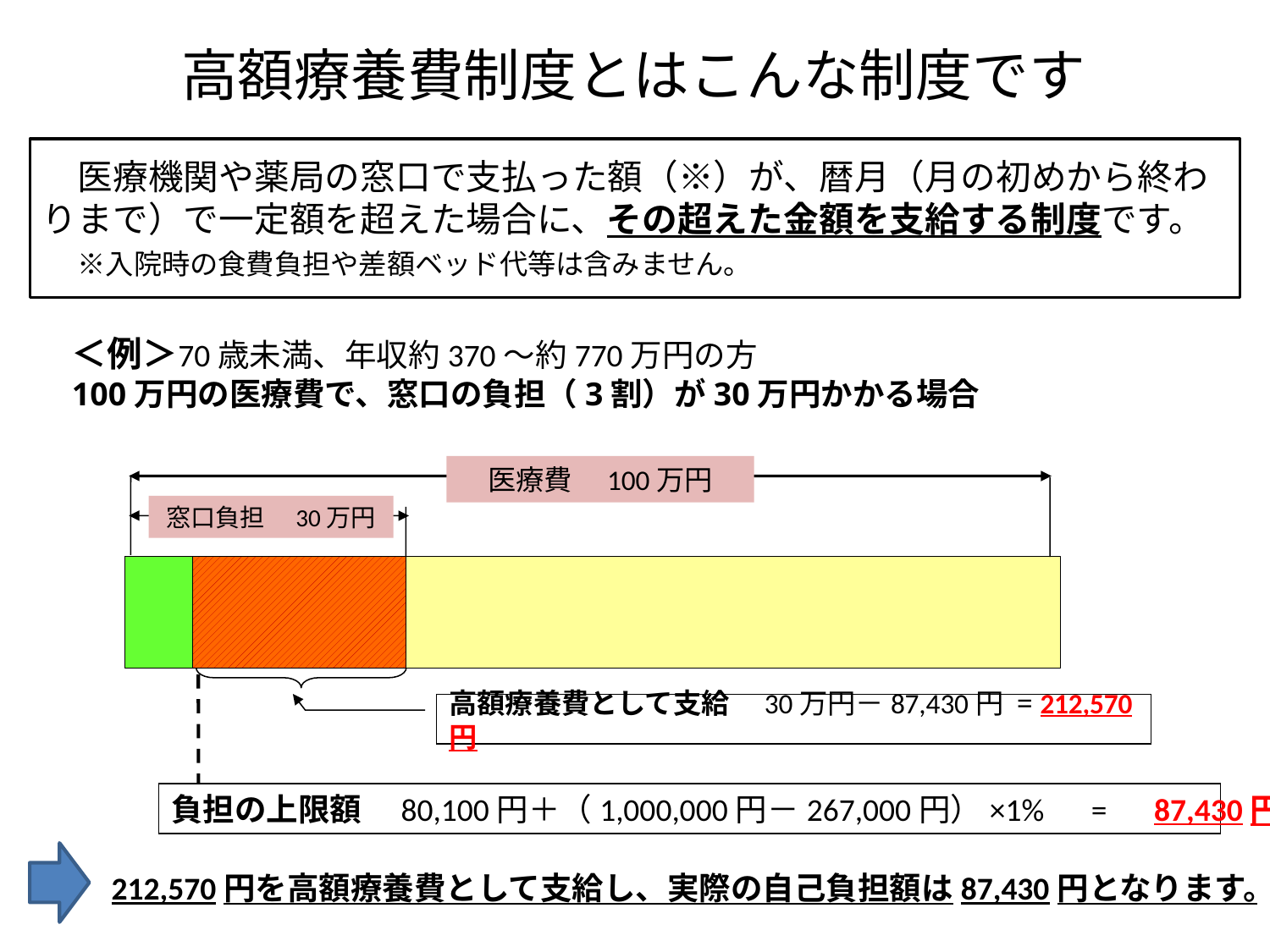
What total medical cost (医療費) does the top arrow of the bar diagram represent? 100万円 What amount is paid out as 高額療養費 according to the diagram? 212,570円 Which is larger, the 高額療養費 paid out or the 負担の上限額? 高額療養費 (212,570円) What fraction of the 医療費 does the 窓口負担 represent, as stated on the slide? 3割 What colour is the hatched segment of the bar that corresponds to the 高額療養費 paid out? Orange What kind of chart is used to illustrate the example? Horizontal stacked bar chart What is the window payment (窓口負担) amount shown above the bar? 30万円 What is the difference between the 窓口負担 of 30万円 and the 負担の上限額 of 87,430円? 212,570円 What colour is the segment of the bar that corresponds to the 負担の上限額 (87,430円)? Green What is the 負担の上限額 (upper limit of self-payment) shown in the diagram? 87,430円 How many coloured segments make up the horizontal bar in the diagram? 3 What is the difference between the 医療費 (100万円) and the 窓口負担 (30万円)? 70万円